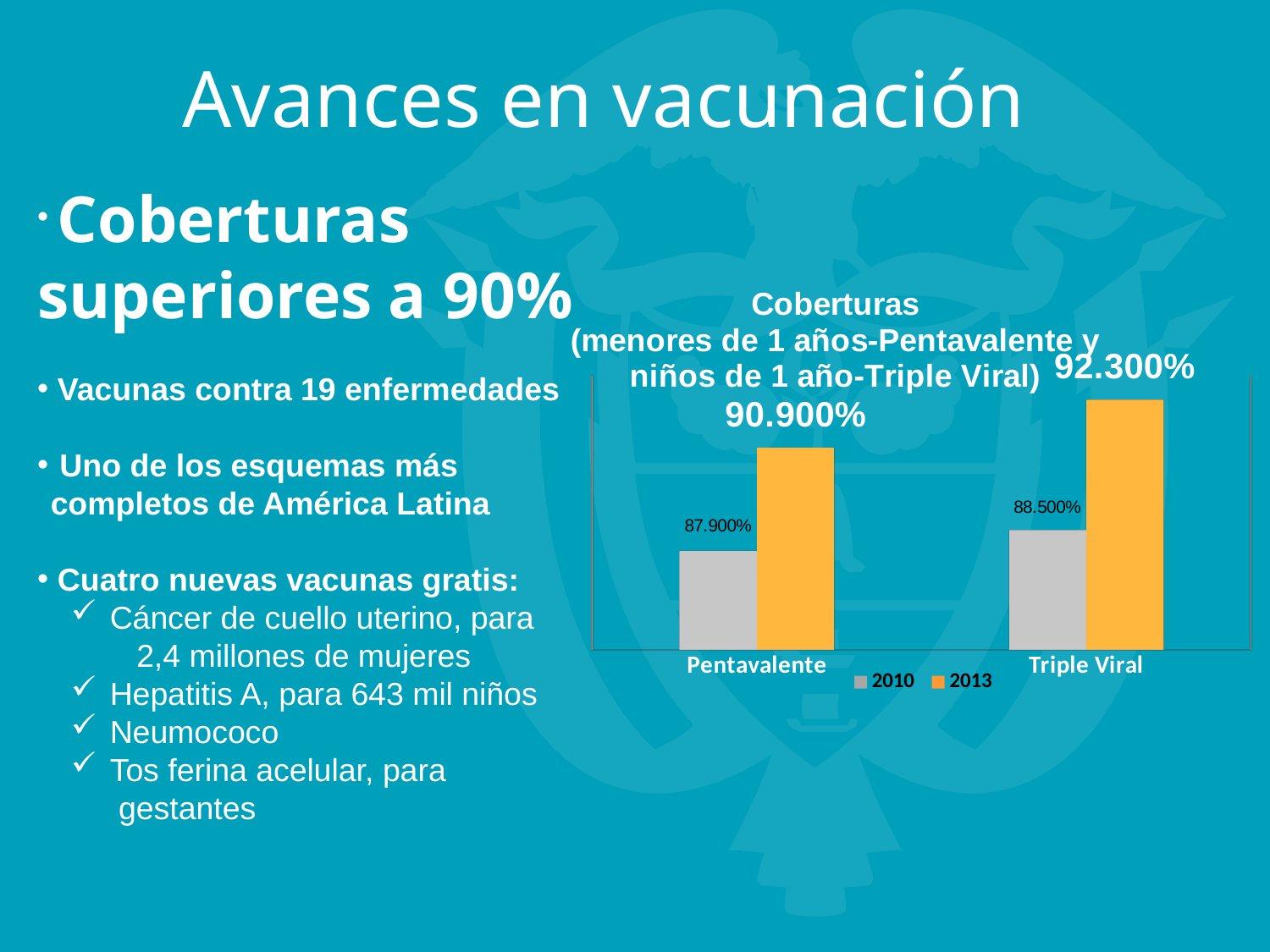
Which bar in the chart has the lowest value? Pentavalente, 2010 Which bar in the chart has the highest value? Triple Viral, 2013 What is the 2013 coverage value for Pentavalente? 90.900% What is the difference between the 2013 and 2010 values for Pentavalente? 3.000% What is the difference between the 2013 and 2010 values for Triple Viral? 3.800% What is the 2013 coverage value for Triple Viral? 92.300% How many series does the chart legend list? 2 What type of chart is shown on the slide? Bar chart What is the 2010 coverage value for Triple Viral? 88.500% Which is larger: the 2013 value for Pentavalente or the 2013 value for Triple Viral? Triple Viral How many categories are shown on the x axis of the chart? 2 What is the 2010 coverage value for Pentavalente? 87.900%